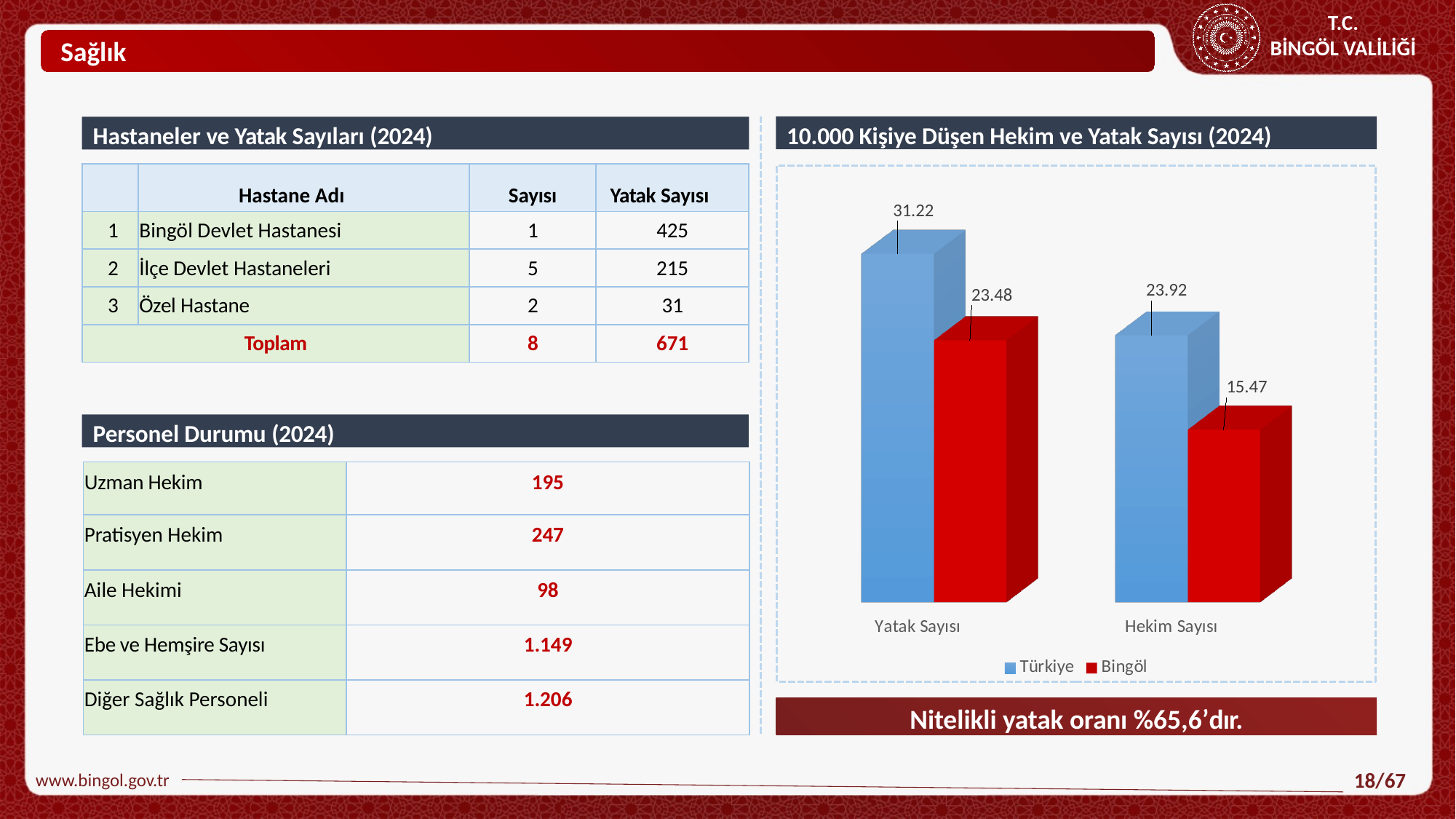
How many categories are shown on the x axis of the chart? 2 How many series does the chart legend list? 2 Which is larger for Hekim Sayısı: the Türkiye value or the Bingöl value? Türkiye Which bar in the chart has the lowest value? Bingöl, Hekim Sayısı What is the value for Türkiye in the Yatak Sayısı category? 31.22 What kind of chart is shown on the slide? Bar chart Which bar in the chart has the highest value? Türkiye, Yatak Sayısı What is the value for Bingöl in the Hekim Sayısı category? 15.47 What is the value for Türkiye in the Hekim Sayısı category? 23.92 What is the difference between the Türkiye and Bingöl values for Hekim Sayısı? 8.45 What is the difference between the Türkiye and Bingöl values for Yatak Sayısı? 7.74 What is the value for Bingöl in the Yatak Sayısı category? 23.48